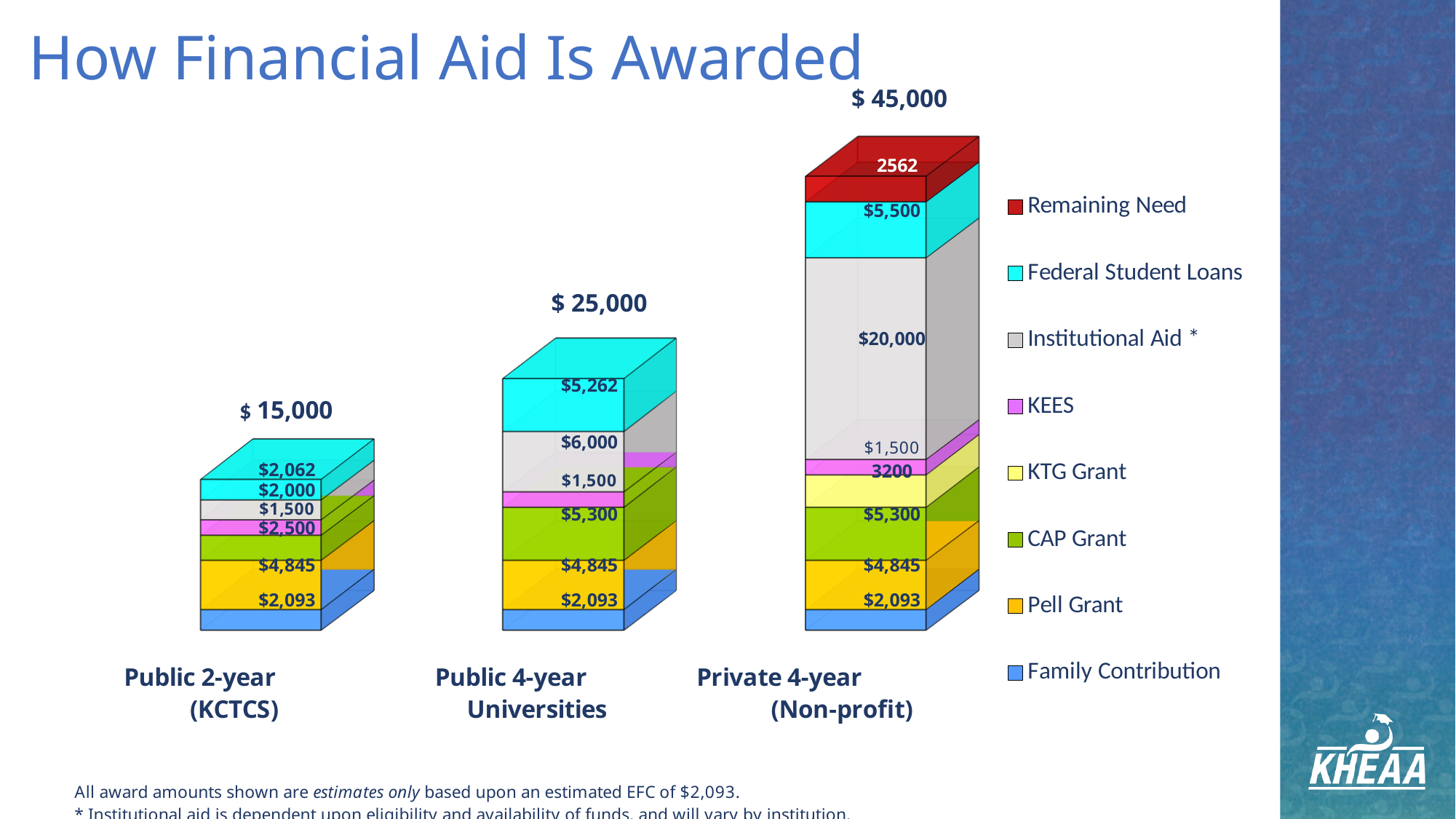
Which is larger: the CAP Grant for Public 2-year (KCTCS) or for Public 4-year Universities? Public 4-year Universities Which institution type has the lowest total? Public 2-year (KCTCS) Which institution type has the highest total? Private 4-year (Non-profit) What is the Federal Student Loans value for Public 2-year (KCTCS)? $2,062 What type of chart is shown on the slide? stacked bar chart What is the Remaining Need value for Private 4-year (Non-profit)? 2562 How many series does the legend list? 8 What is the Institutional Aid value for Public 4-year Universities? $6,000 How many institution types (categories) are shown on the chart? 3 What is the total shown above the Public 2-year (KCTCS) bar? $ 15,000 What is the total shown above the Private 4-year (Non-profit) bar? $ 45,000 What is the difference between the Institutional Aid for Private 4-year (Non-profit) and for Public 4-year Universities? $14,000